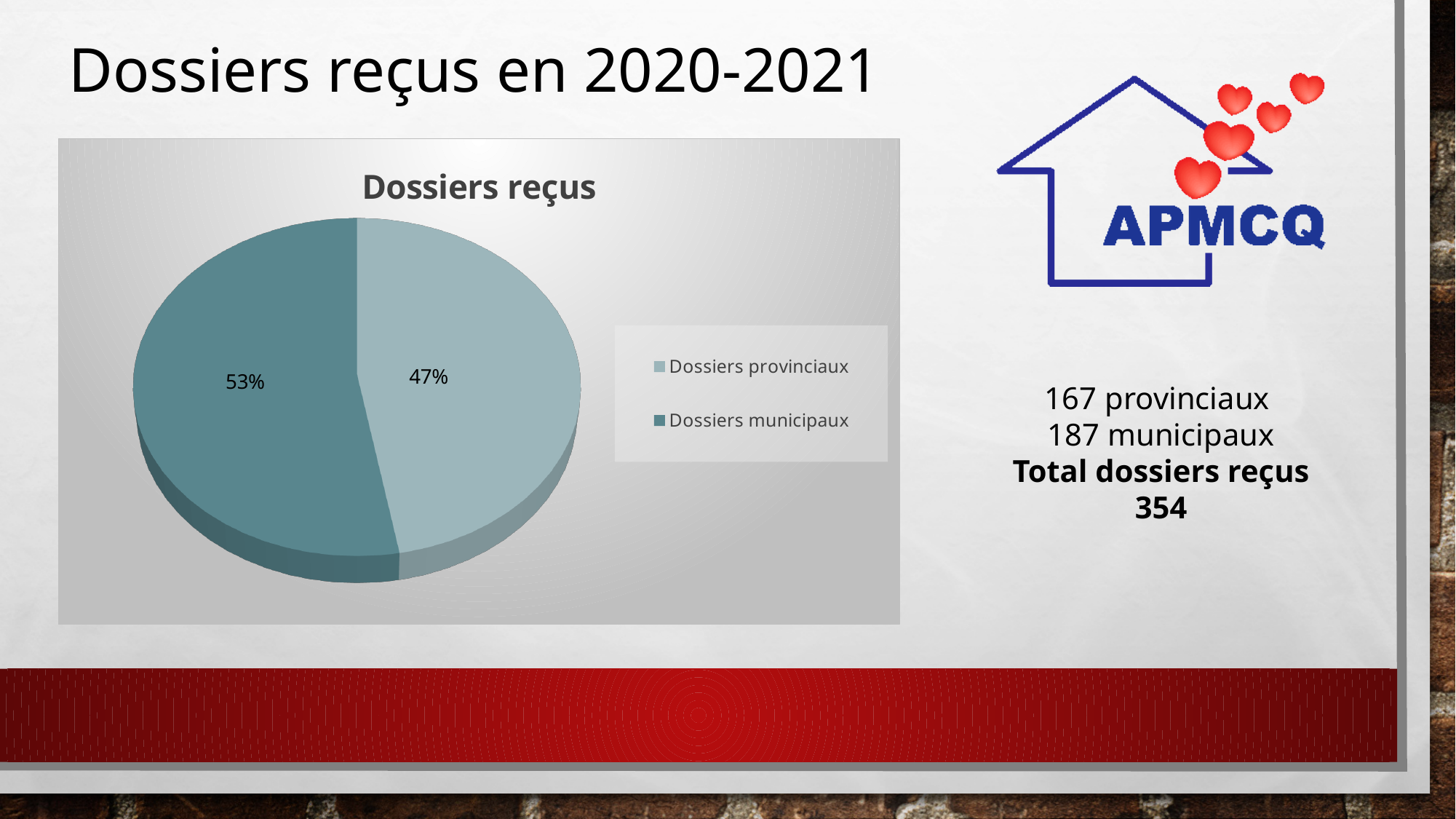
What is the chart's title? Dossiers reçus What share of the pie is Dossiers municipaux? 53% What kind of chart is shown on the slide? pie chart Is the share for Dossiers provinciaux greater or less than 50%? less What is the difference in percentage points between Dossiers municipaux and Dossiers provinciaux? 6 What share of the pie is Dossiers provinciaux? 47% Which is larger, Dossiers provinciaux or Dossiers municipaux? Dossiers municipaux How many slices does the pie chart have? 2 Which slice is the largest? Dossiers municipaux Which slice is the smallest? Dossiers provinciaux How many entries does the legend list? 2